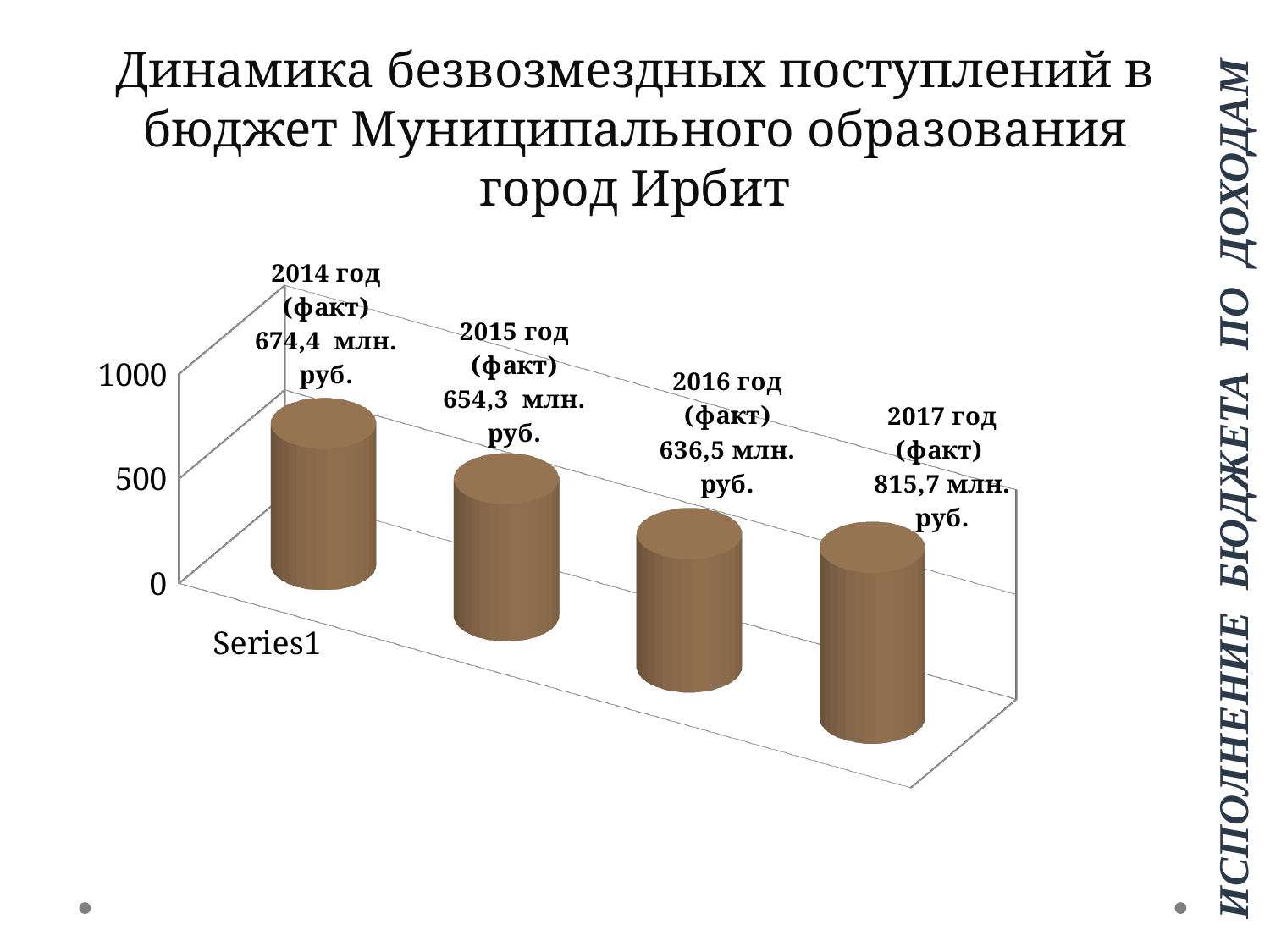
Is the value for 2017 greater or less than 500? greater From 2014 to 2016, do the values rise or fall? fall Which is larger, the value for 2014 or the value for 2015? 2014 What is the difference between the values for 2017 and 2016? 179,2 млн. руб. What is the value for 2017 год (факт)? 815,7 млн. руб. What is the value for 2014 год (факт)? 674,4 млн. руб. Which year has the highest value? 2017 год What is the value for 2016 год (факт)? 636,5 млн. руб. What is the difference between the values for 2014 and 2015? 20,1 млн. руб. Which year has the lowest value? 2016 год What kind of chart is shown on the slide? bar chart How many years are shown on the chart? 4